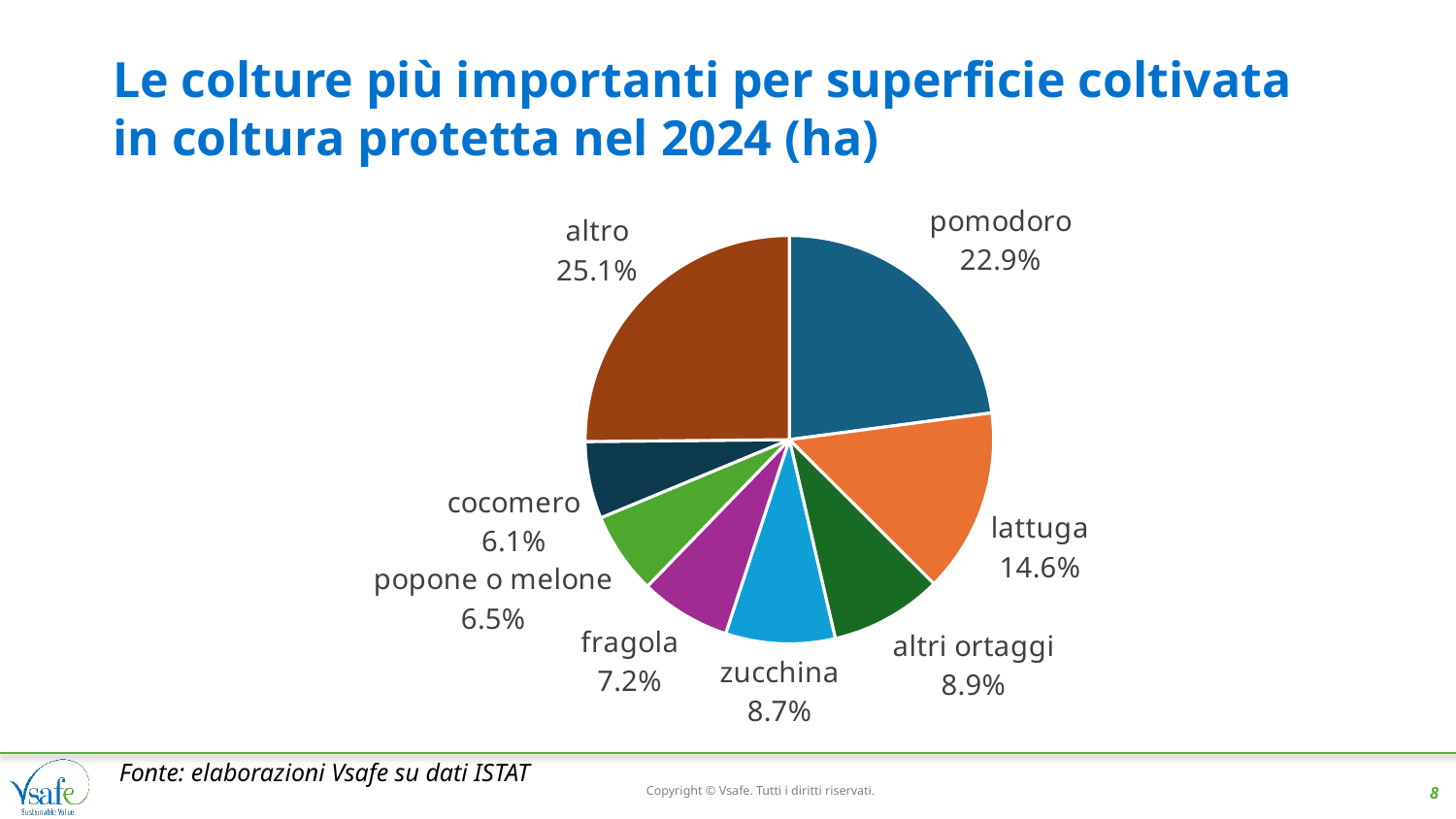
What is the difference in percentage points between pomodoro and lattuga? 8.3 Which is larger, the share for fragola or the share for popone o melone? fragola How many slices does the pie chart have? 8 Which slice has the smallest share of the pie? cocomero What share of the pie does pomodoro have? 22.9% What is the value shown for zucchina? 8.7% What is the value shown for lattuga? 14.6% What is the value shown for cocomero? 6.1% What is the title of the chart on the slide? Le colture più importanti per superficie coltivata in coltura protetta nel 2024 (ha) What is the difference in percentage points between altro and pomodoro? 2.2 Which slice has the largest share of the pie? altro What kind of chart is shown on the slide? pie chart